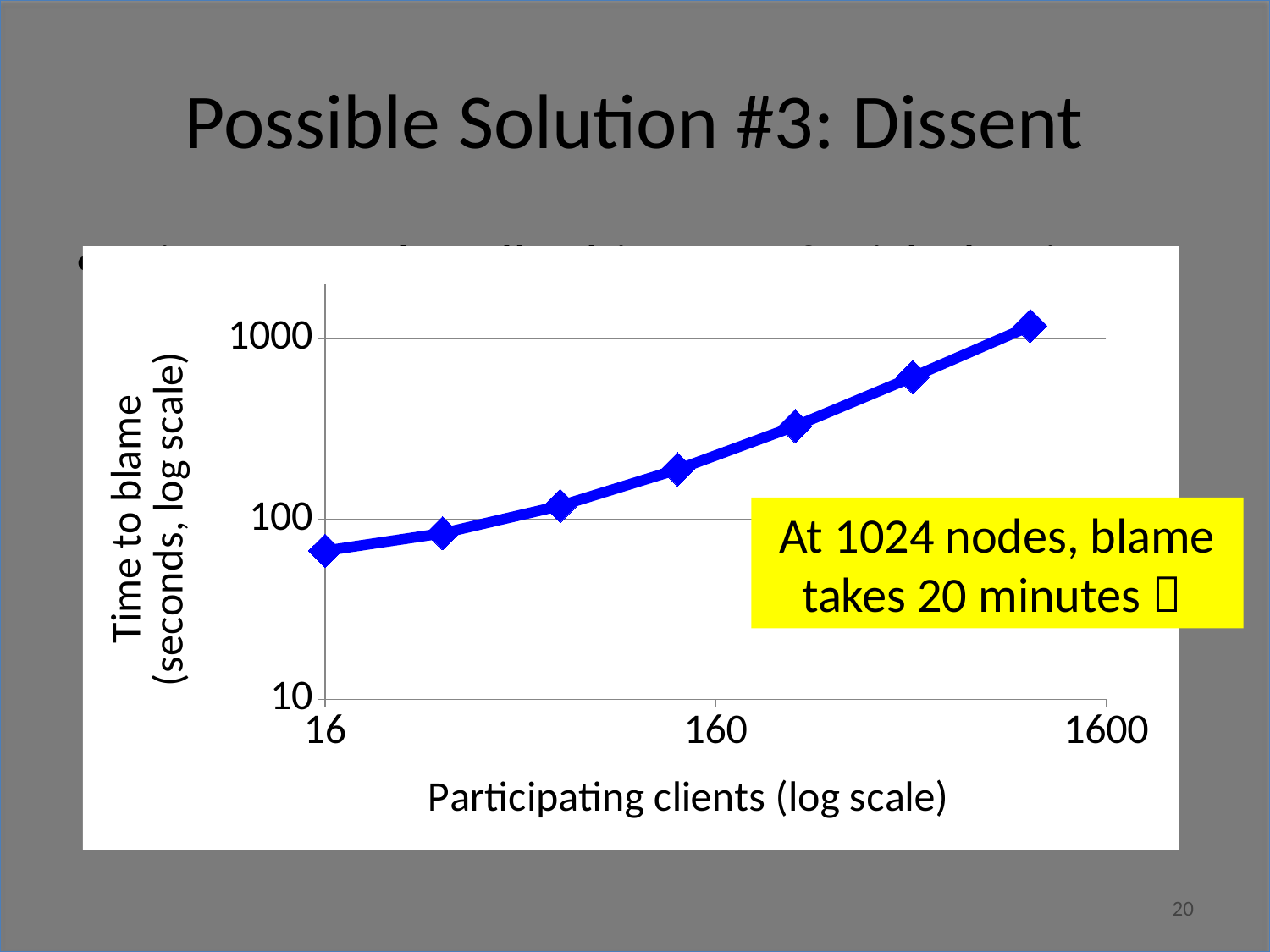
What kind of chart is shown on the slide? line chart Is the time to blame for the leftmost data point greater or less than 10 seconds? greater Is the time to blame at 16 participating clients greater or less than 100 seconds? less What is the label of the y axis? Time to blame (seconds, log scale) Which data point has the lowest time to blame? the leftmost point, at 16 participating clients How many data points are plotted on the line? 7 Does the time to blame rise or fall as the number of participating clients increases? rise What is the label of the x axis? Participating clients (log scale) Is the time to blame for the rightmost data point greater or less than 1000 seconds? greater Which data point has the higher time to blame, the leftmost or the rightmost? the rightmost